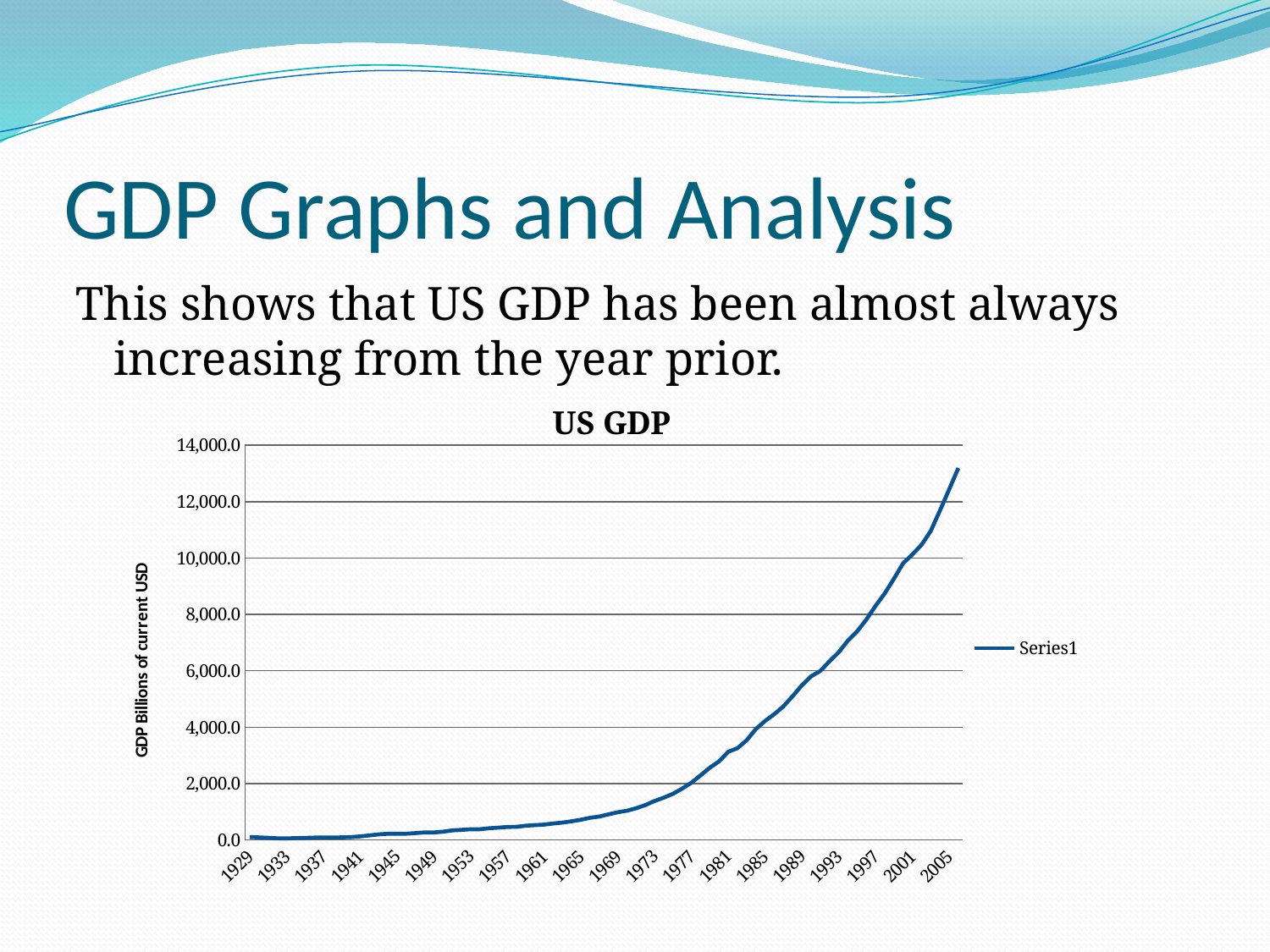
Is the value for 1989 greater or less than 6,000.0? less Is the value for 1961 greater or less than 2,000.0? less Do the values generally rise or fall from 1929 to 2005? rise What is the title of the chart? US GDP What kind of chart is shown on the slide? line chart Is the value for 1973 greater or less than 2,000.0? less Which is larger, the value for 2001 or the value for 1993? 2001 What is the label on the vertical axis of the chart? GDP Billions of current USD How many series does the legend list? 1